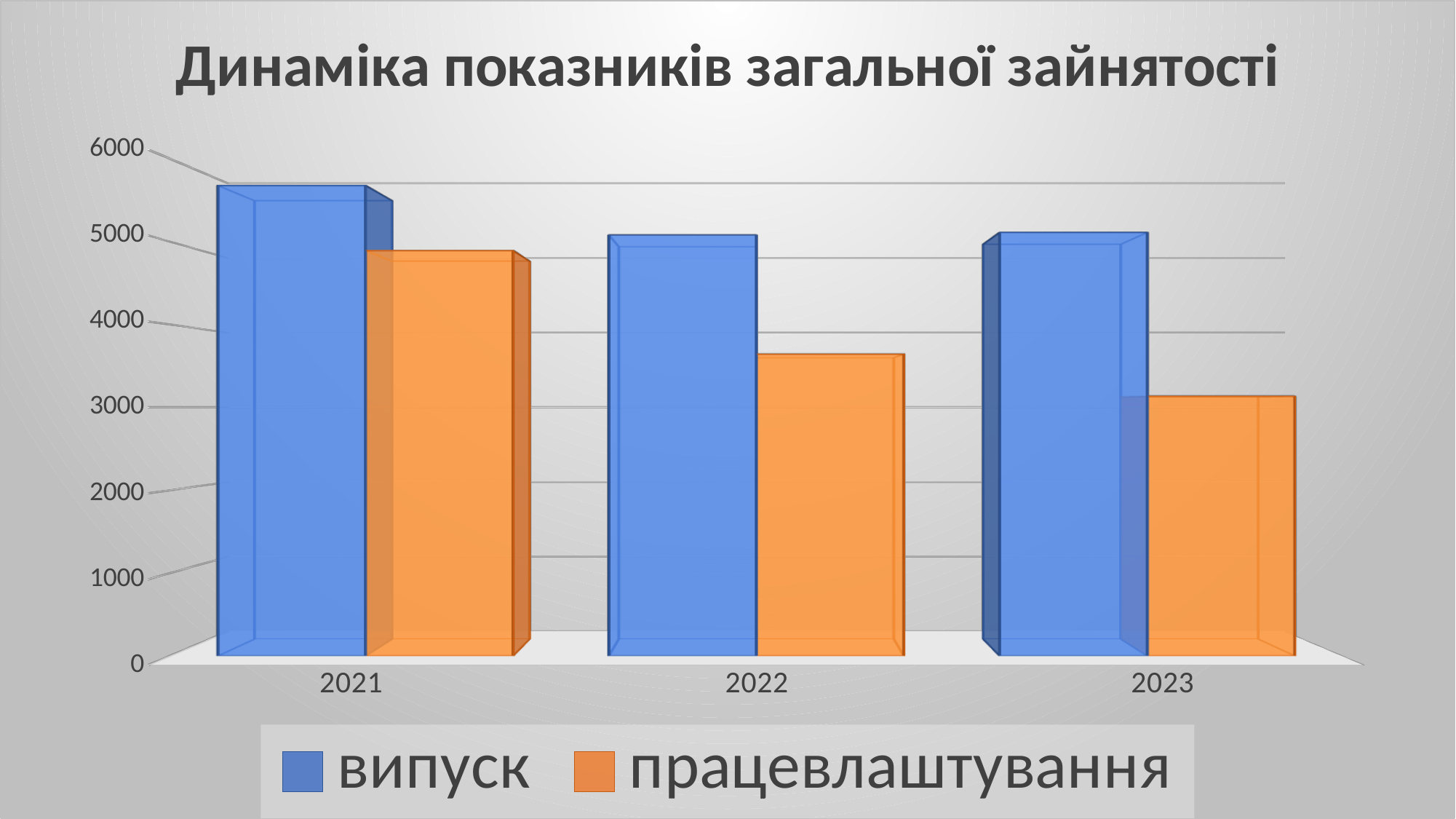
Do the values for 'працевлаштування' rise or fall from 2021 to 2023? fall Which colour represents the series 'працевлаштування'? orange In which year is the value for 'працевлаштування' the lowest? 2023 What kind of chart is shown on the slide? bar chart In which year is the value for 'випуск' the highest? 2021 How many series does the legend list? 2 Is the value for 'випуск' in 2021 greater or less than 5000? greater In 2022, which is larger: 'випуск' or 'працевлаштування'? випуск In which year is the value for 'працевлаштування' the highest? 2021 Is the value for 'працевлаштування' in 2022 greater or less than 4000? less What is the title of the chart? Динаміка показників загальної зайнятості How many years are shown on the x axis? 3